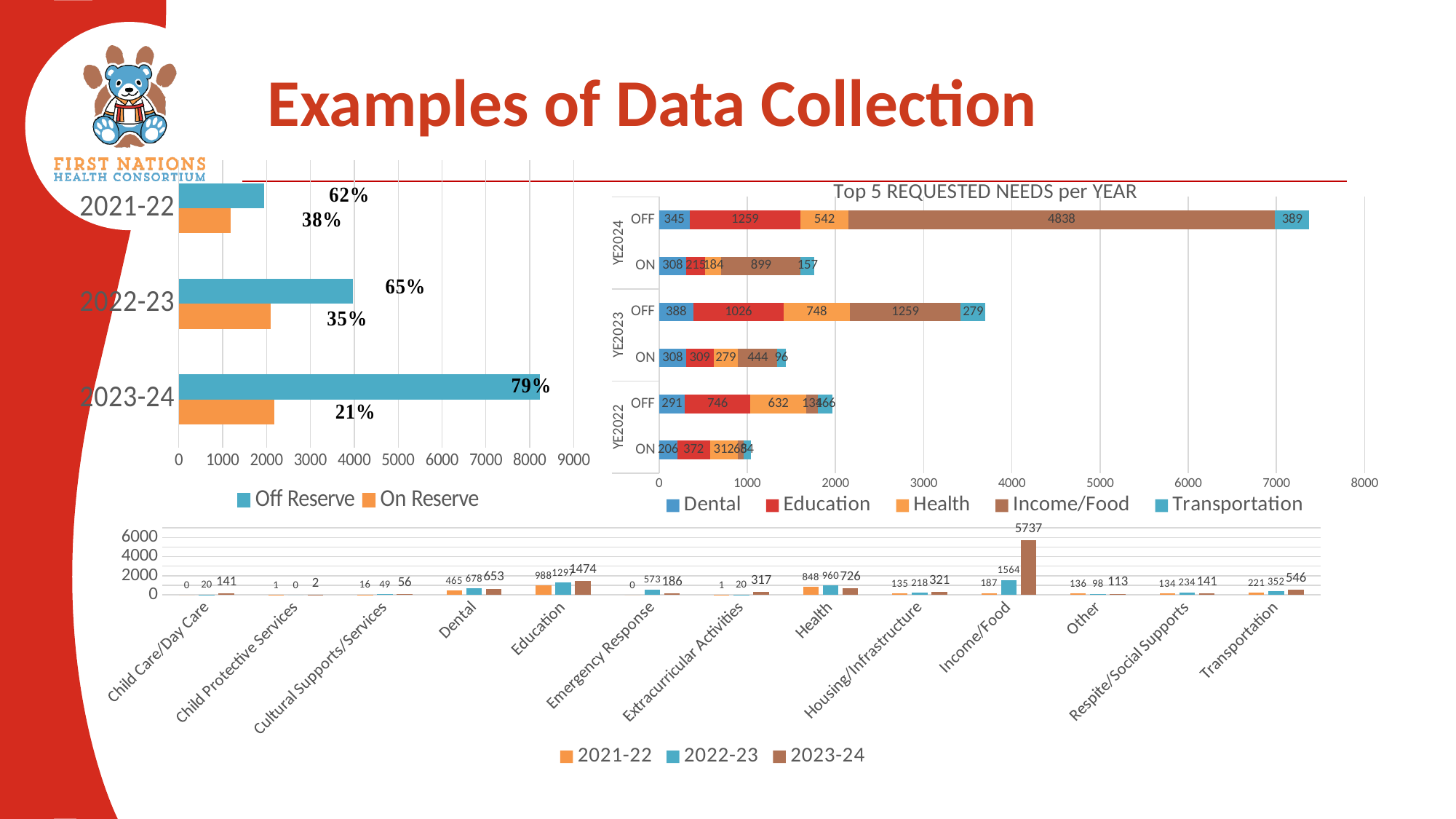
In the 'Top 5 REQUESTED NEEDS per YEAR' chart, what is the Education value for YE2023 OFF? 1026 In the top-left chart, what is the On Reserve percentage label for 2022-23? 35% In the top-left chart, is the Off Reserve bar for 2023-24 greater or less than 8000? greater In the bottom chart, what is the 2023-24 value for Income/Food? 5737 In the 'Top 5 REQUESTED NEEDS per YEAR' chart, what is the Income/Food value for YE2024 OFF? 4838 In the bottom chart, which category has the highest 2022-23 value? Income/Food In the 'Top 5 REQUESTED NEEDS per YEAR' chart, what is the total of the YE2024 ON stacked bar? 1763 In the bottom chart, what is the difference between the 2023-24 and 2021-22 values for Education? 486 In the 'Top 5 REQUESTED NEEDS per YEAR' chart, how many series does the legend list? 5 In the bottom chart, how many categories are shown on the x axis? 13 In the top-left chart, how many series does the legend list? 2 In the top-left chart, what is the Off Reserve percentage label for 2023-24? 79%